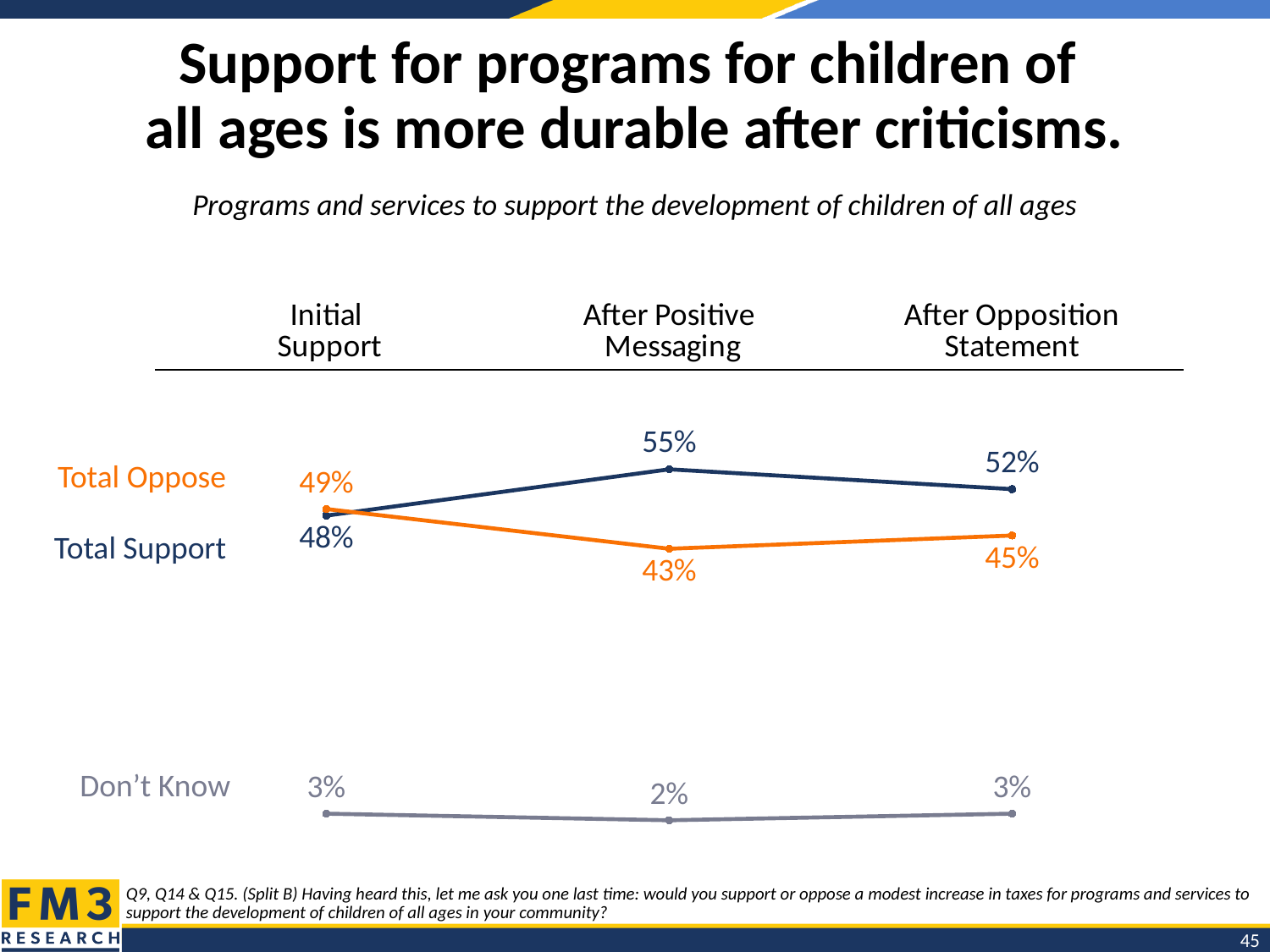
At which stage is Total Oppose lowest? After Positive Messaging Which is larger at Initial Support: Total Support or Total Oppose? Total Oppose What is the Total Oppose value at Initial Support? 49% What is the difference between Total Support and Total Oppose after the opposition statement? 7 percentage points How many series are plotted on the chart? 3 At which stage is Total Support highest? After Positive Messaging Does Total Oppose rise or fall from Initial Support to After Positive Messaging? Fall What kind of chart is shown on the slide? Line chart What is the Total Support value after the opposition statement? 52% What is the Don't Know value after positive messaging? 2% How many stages are plotted along the x axis? 3 What is the Total Support value after positive messaging? 55%